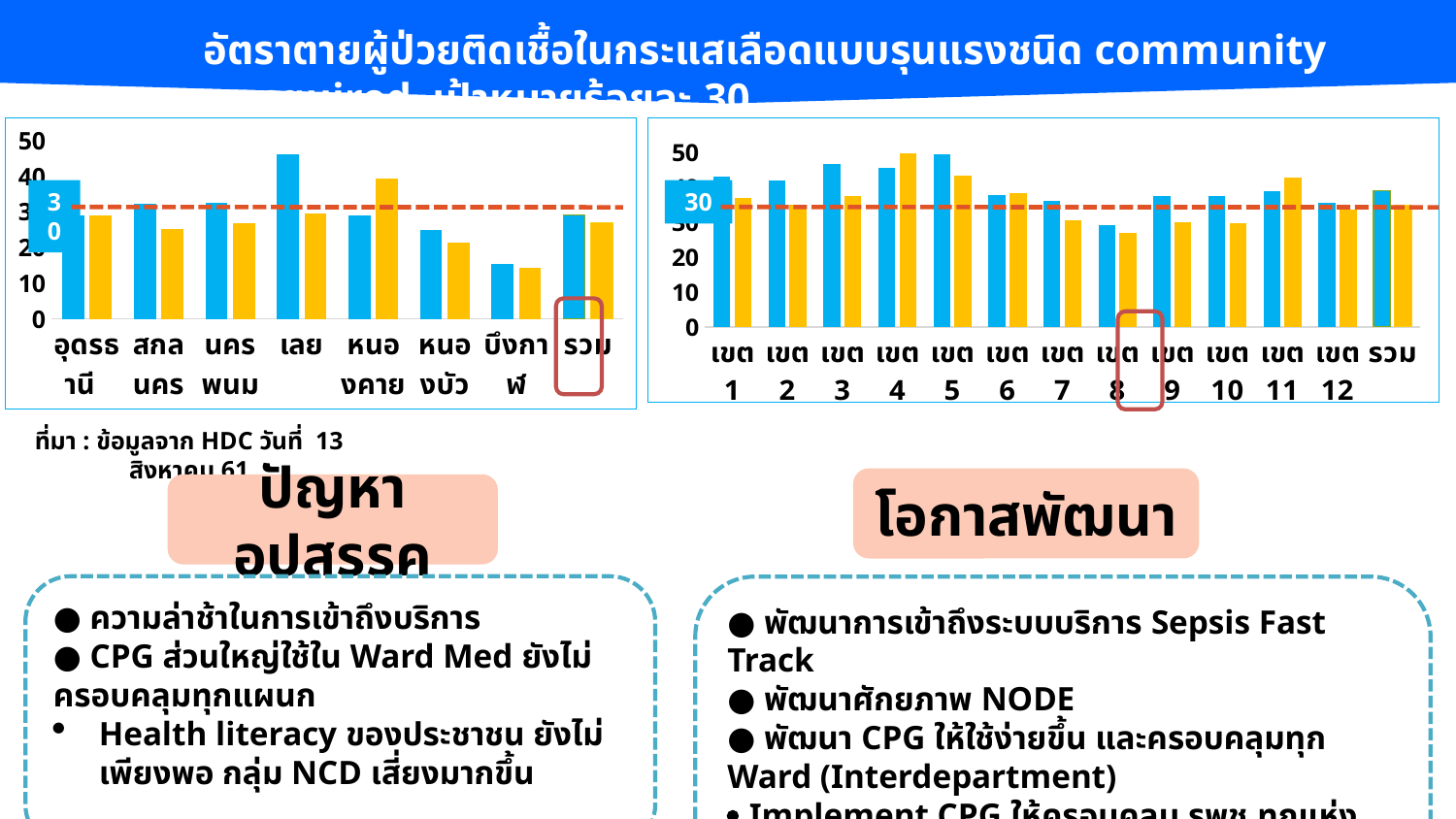
In the right chart, which is larger: the blue bar for เขต 5 or the blue bar for เขต 8? เขต 5 In the right chart, which category has the lowest yellow bar? เขต 8 How many categories are shown on the x axis of the right chart? 13 How many categories are shown on the x axis of the left chart? 8 In the left chart, is the blue bar for บึงกาฬ greater or less than 20? less In the left chart, is the blue bar for เลย greater or less than 40? greater What value does the dashed red horizontal line mark on both charts? 30 In the left chart, which category has the highest yellow bar? หนองคาย In the left chart, which category has the lowest blue bar? บึงกาฬ In the right chart, is the yellow bar for เขต 4 greater or less than 40? greater What kind of chart is the left chart on the slide? bar chart In the left chart, which category has the highest blue bar? เลย